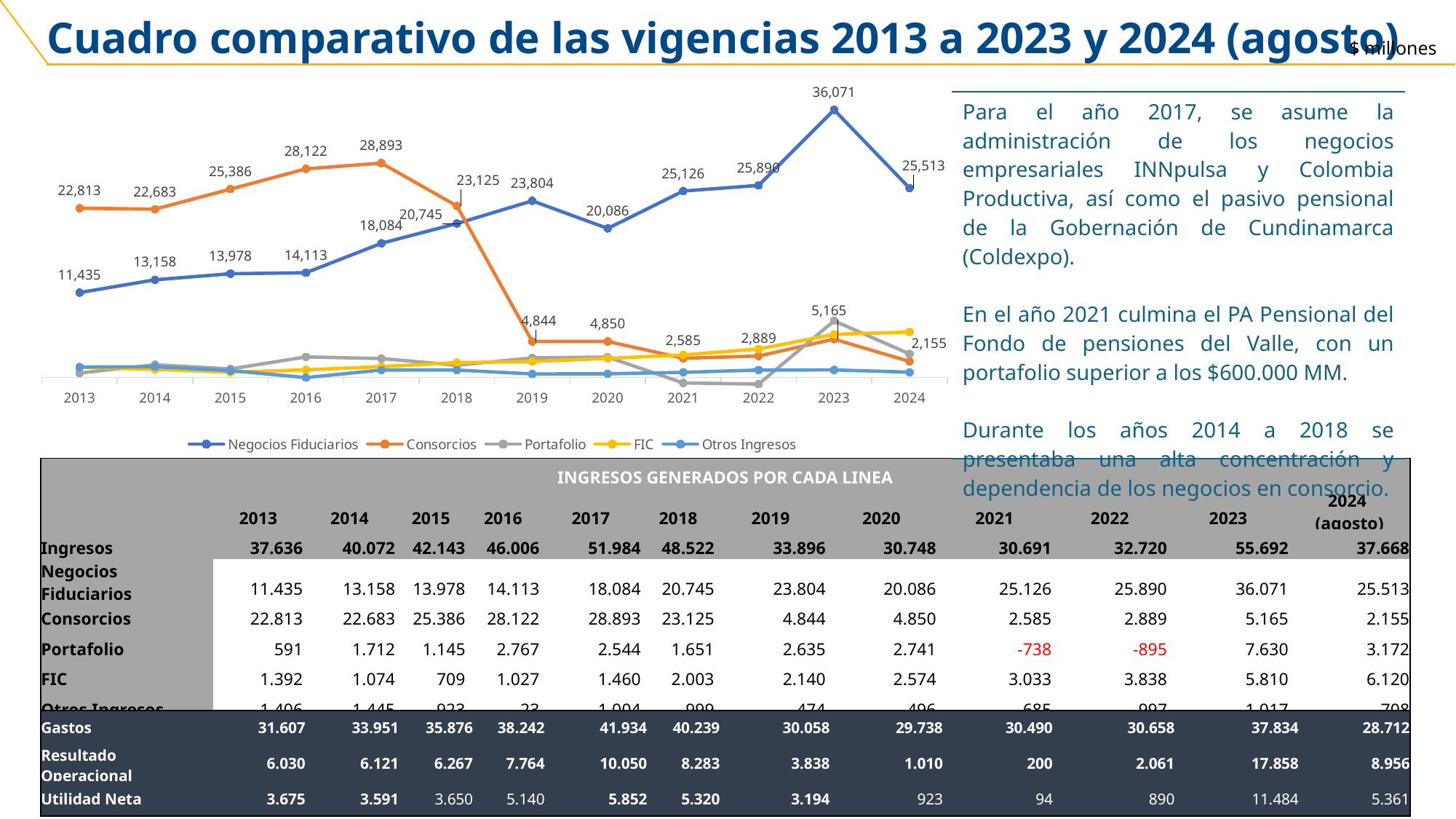
In 2016, which is larger: Consorcios or Negocios Fiduciarios? Consorcios What is the value for Consorcios in 2017? 28,893 What is the difference between the Negocios Fiduciarios values for 2023 and 2024? 10,558 How many series does the chart legend list? 5 What type of chart is shown on the slide? Line chart What is the value for Negocios Fiduciarios in 2023? 36,071 In which year does the Negocios Fiduciarios series have its lowest value? 2013 What is the value for Consorcios in 2024? 2,155 How many years are shown on the x axis of the chart? 12 In which year does the Consorcios series reach its highest value? 2017 In which year does the Negocios Fiduciarios series reach its highest value? 2023 By how much did the Consorcios value fall from 2018 to 2019? 18,281